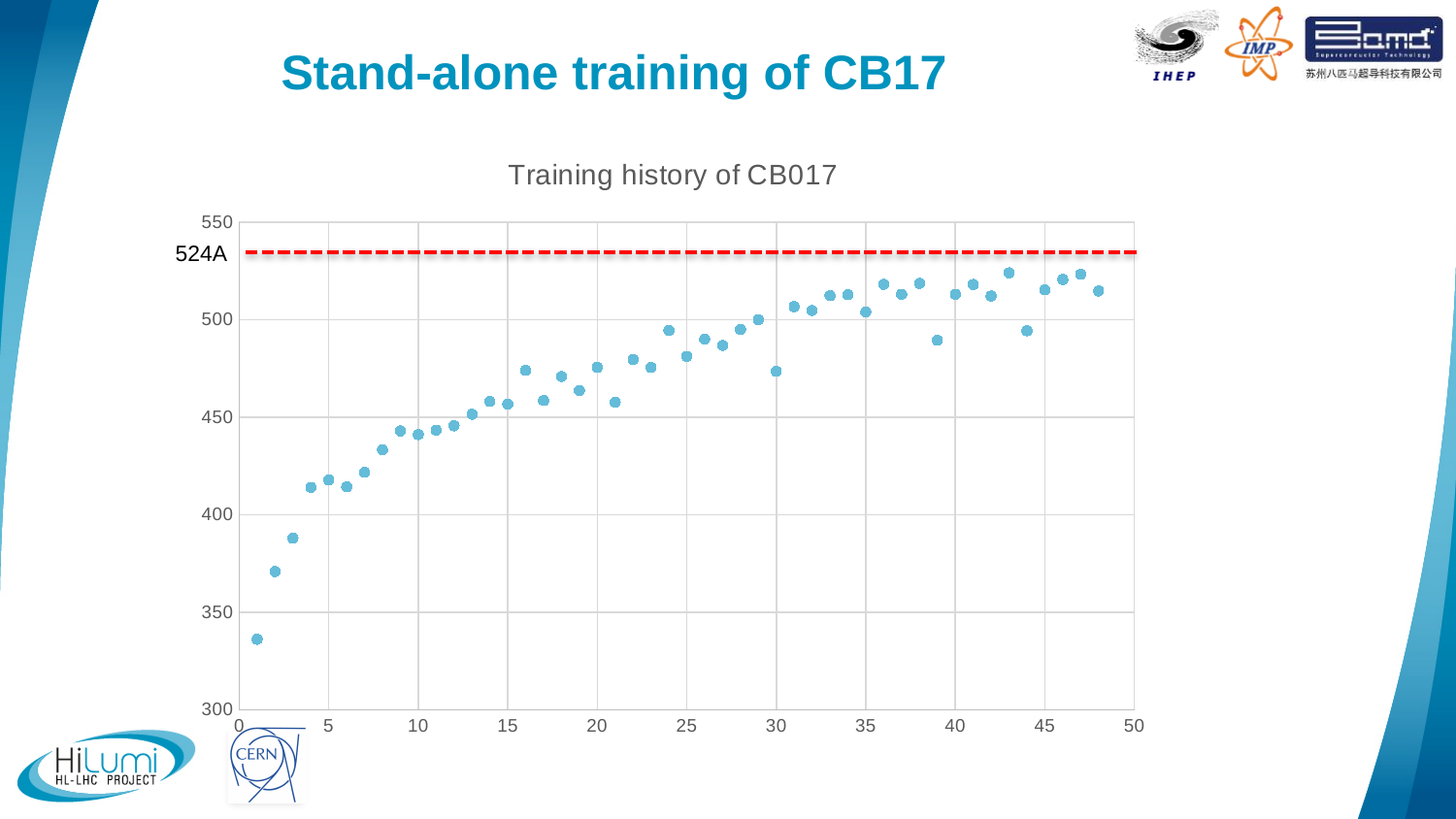
Which point has the larger value, the one at x = 5 or the one at x = 25? x = 25 What kind of chart is shown on the slide? scatter chart What is the title of the chart? Training history of CB017 What is the highest value shown on the y axis? 550 Is the value of the point at x = 20 greater or less than 450? greater Is the value of the point at x = 30 greater or less than 500? less Do the plotted values generally rise or fall as the x value increases from 0 to 50? rise Is the value of the point at x = 10 greater or less than 450? less At which x value is the lowest point on the chart? 1 What value is labelled on the red dashed horizontal line? 524A